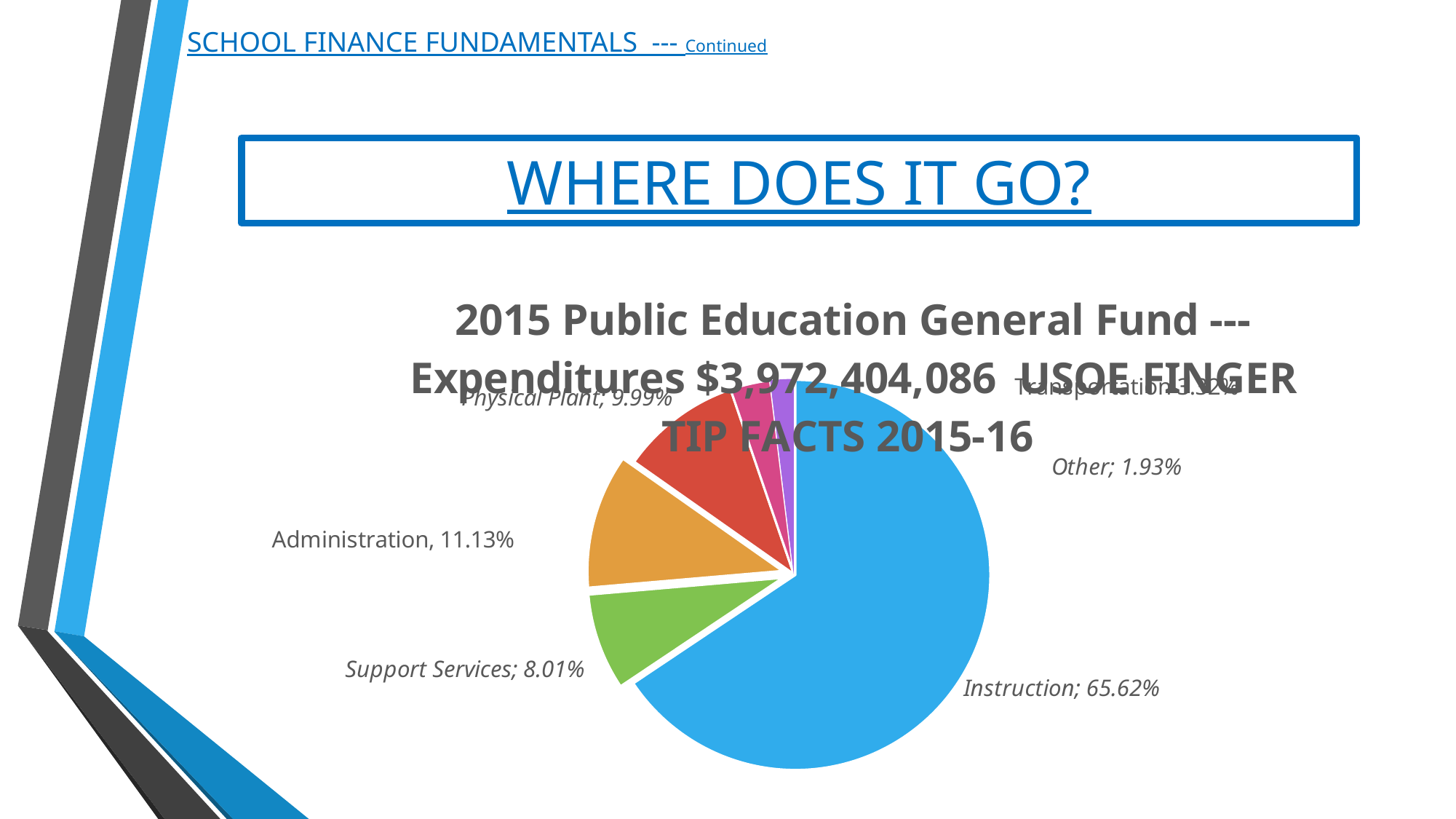
Which is larger, the share for Administration or the share for Physical Plant? Administration Which category has the largest slice of the pie? Instruction What share of expenditures goes to Instruction? 65.62% What total expenditure amount is given in the chart title? $3,972,404,086 What percentage is shown for Administration? 11.13% What percentage is shown for Other? 1.93% What percentage is shown for Physical Plant? 9.99% What percentage is shown for Support Services? 8.01% How many slices does the pie chart have? 6 What is the difference in percentage points between Administration and Support Services? 3.12% Which category has the smallest slice of the pie? Other What kind of chart is shown on the slide? pie chart